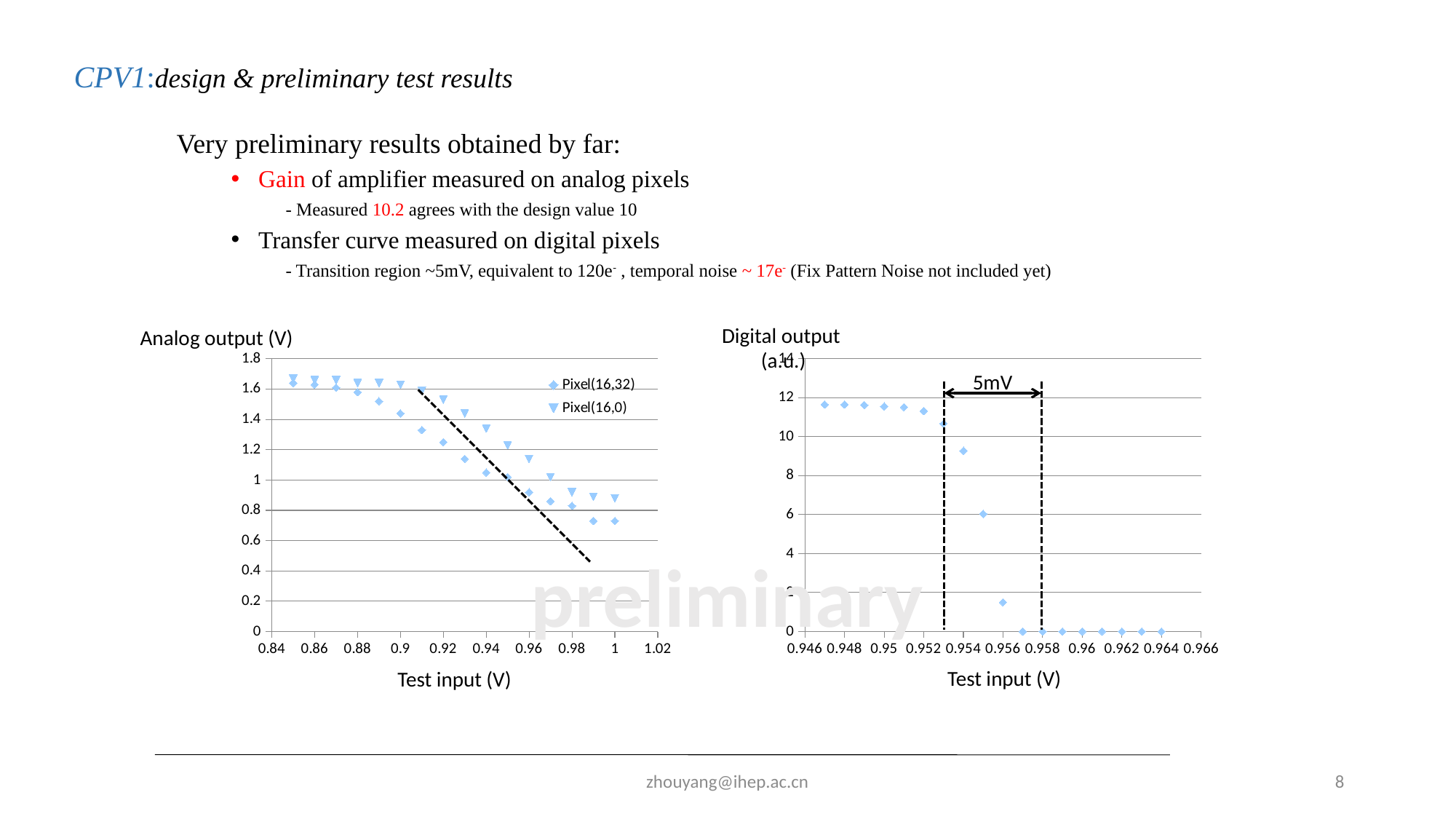
What are the two series named in the legend of the left chart (Analog output)? Pixel(16,32) and Pixel(16,0) In the left chart (Analog output), do the values for Pixel(16,32) rise or fall as the test input increases? fall In the left chart (Analog output), is the value for Pixel(16,32) at a test input of 1 V greater or less than 0.8? less In the right chart (Digital output), is the value at a test input of 0.96 V greater or less than 2? less What width is annotated between the two dashed vertical lines in the right chart (Digital output)? 5mV In the left chart (Analog output), is the value for Pixel(16,0) at a test input of 0.85 V greater or less than 1.6? greater How many series does the legend of the left chart (Analog output) list? 2 In the left chart (Analog output), at a test input of 0.94 V, which series has the larger value, Pixel(16,32) or Pixel(16,0)? Pixel(16,0) In the right chart (Digital output), which test input has the larger digital output, 0.95 V or 0.96 V? 0.95 V What kind of chart is the left chart (Analog output vs Test input)? scatter chart In the right chart (Digital output), do the values rise or fall as the test input increases? fall